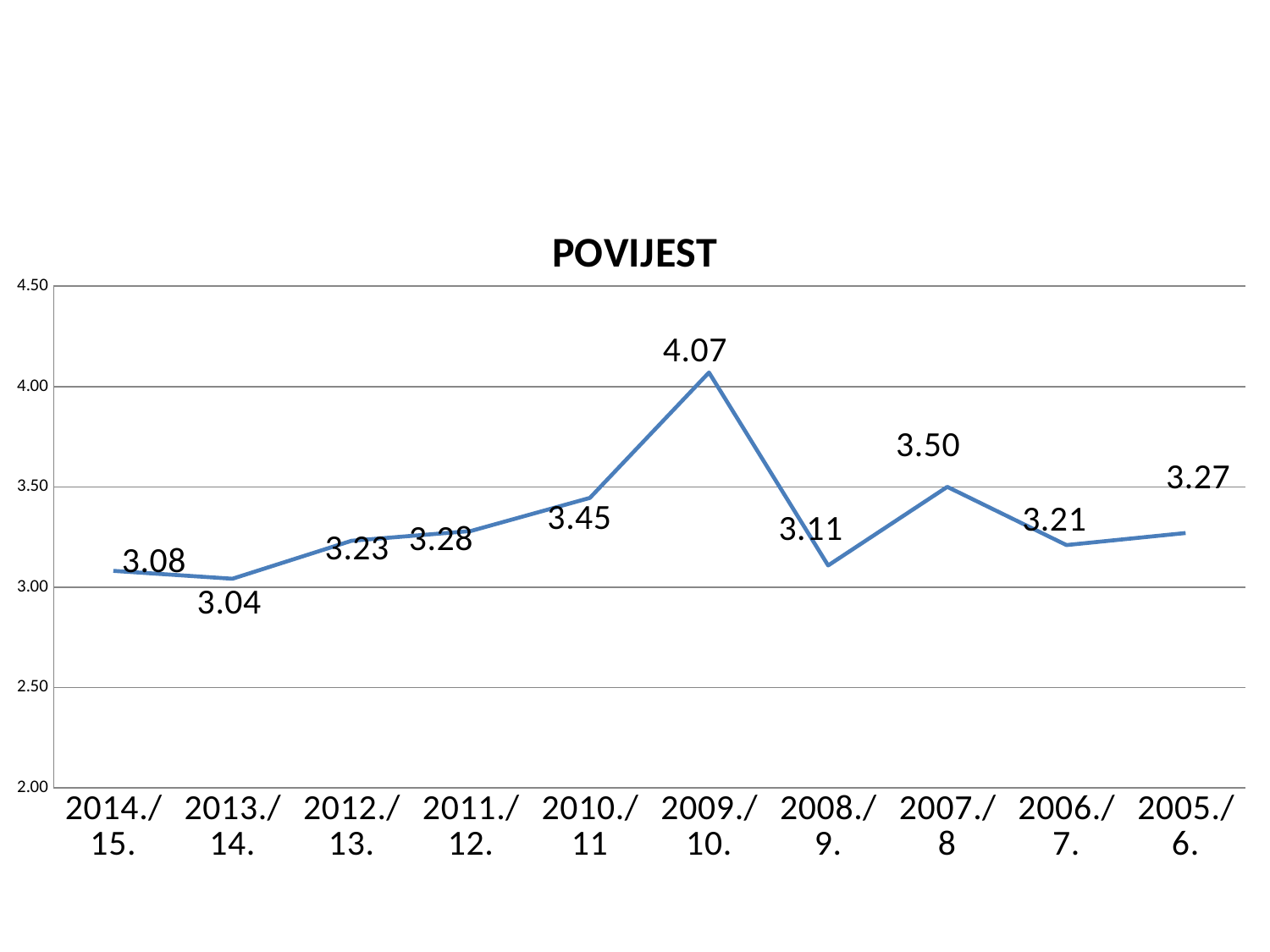
What is the value for 2009./10.? 4.07 Do the values rise or fall from 2014./15. to 2009./10.? rise What is the value for 2013./14.? 3.04 Which category has the lowest value? 2013./14. Which is larger, the value for 2007./8 or the value for 2006./7.? 2007./8 What kind of chart is this? line chart What is the value for 2005./6.? 3.27 What is the title of the chart? POVIJEST Is the value for 2010./11 greater or less than 3.50? less How many categories are shown on the x axis? 10 What is the difference between the values for 2009./10. and 2008./9.? 0.96 Which category has the highest value? 2009./10.